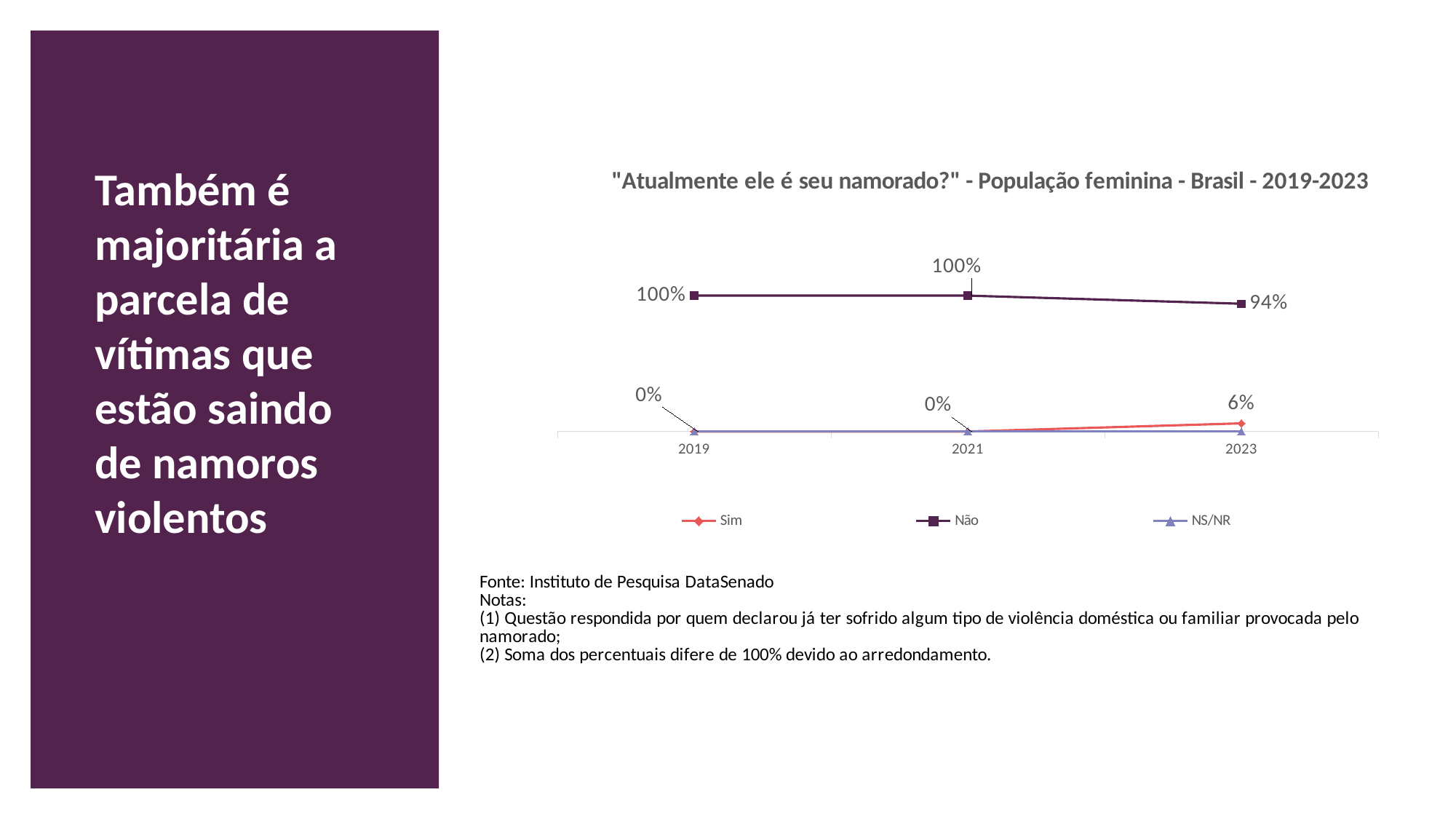
What is the value for "Sim" in 2019? 0% What is the value for "Não" in 2023? 94% In which year is the value for "Não" lowest? 2023 What kind of chart is shown on the slide? line chart What is the difference between the "Não" value in 2021 and in 2023? 6% How many years are shown on the x axis? 3 Does the value for "Não" rise or fall from 2021 to 2023? fall What are the three series listed in the legend? Sim, Não, NS/NR What is the value for "Não" in 2019? 100% Which is larger in 2023, the value for "Sim" or the value for "Não"? Não How many series does the legend list? 3 What is the value for "Sim" in 2023? 6%